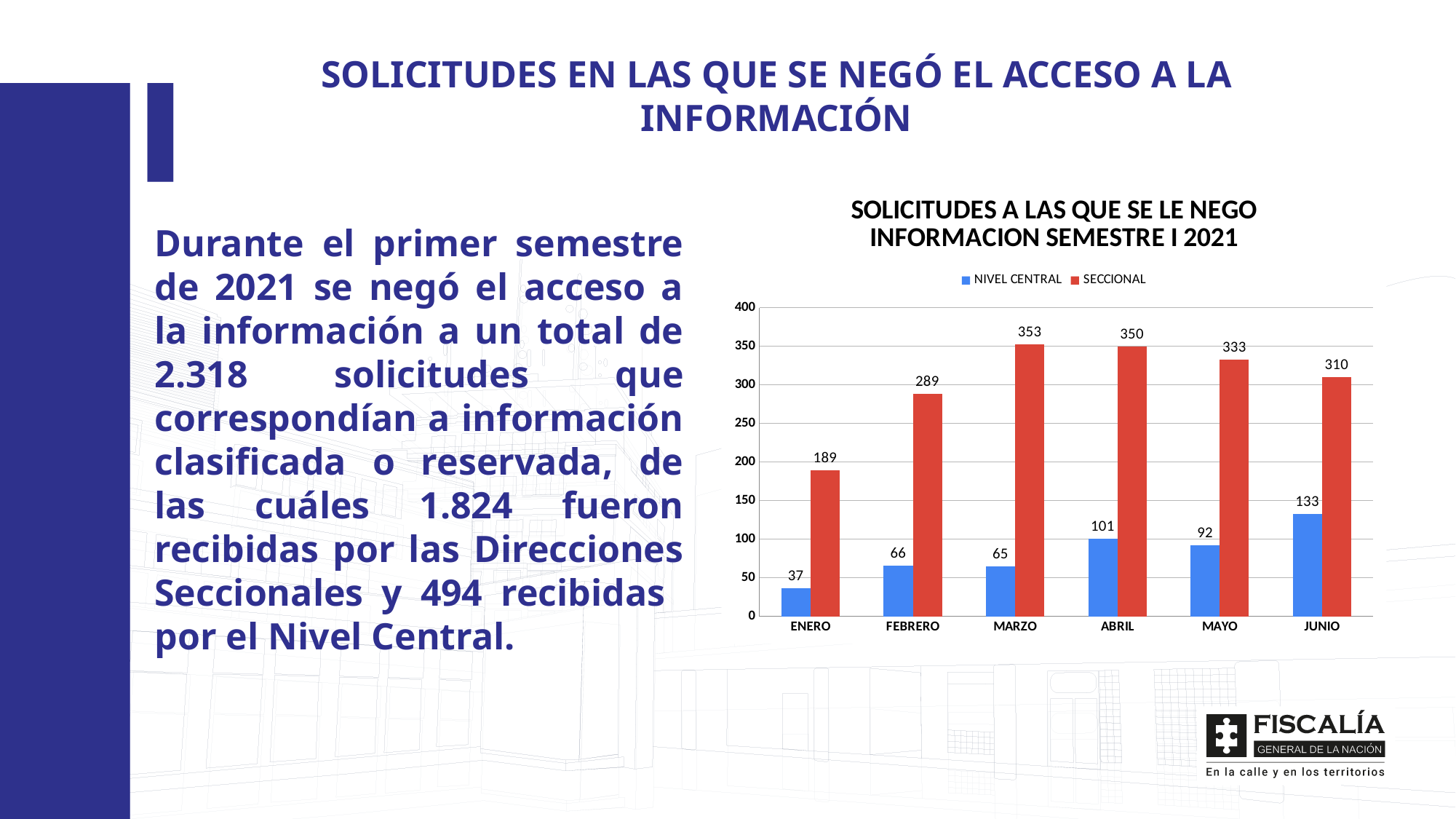
What is the SECCIONAL value for MARZO? 353 What is the difference between the SECCIONAL and NIVEL CENTRAL values for ABRIL? 249 What is the NIVEL CENTRAL value for ENERO? 37 What is the NIVEL CENTRAL value for JUNIO? 133 Which month has the lowest NIVEL CENTRAL value? ENERO Is the SECCIONAL value for FEBRERO greater or less than 250? greater How many series does the legend list? 2 Which month has the highest SECCIONAL value? MARZO What is the title of the chart? SOLICITUDES A LAS QUE SE LE NEGO INFORMACION SEMESTRE I 2021 Which is larger, the NIVEL CENTRAL value for MAYO or for JUNIO? JUNIO What kind of chart is shown? bar chart How many months are shown on the x axis? 6